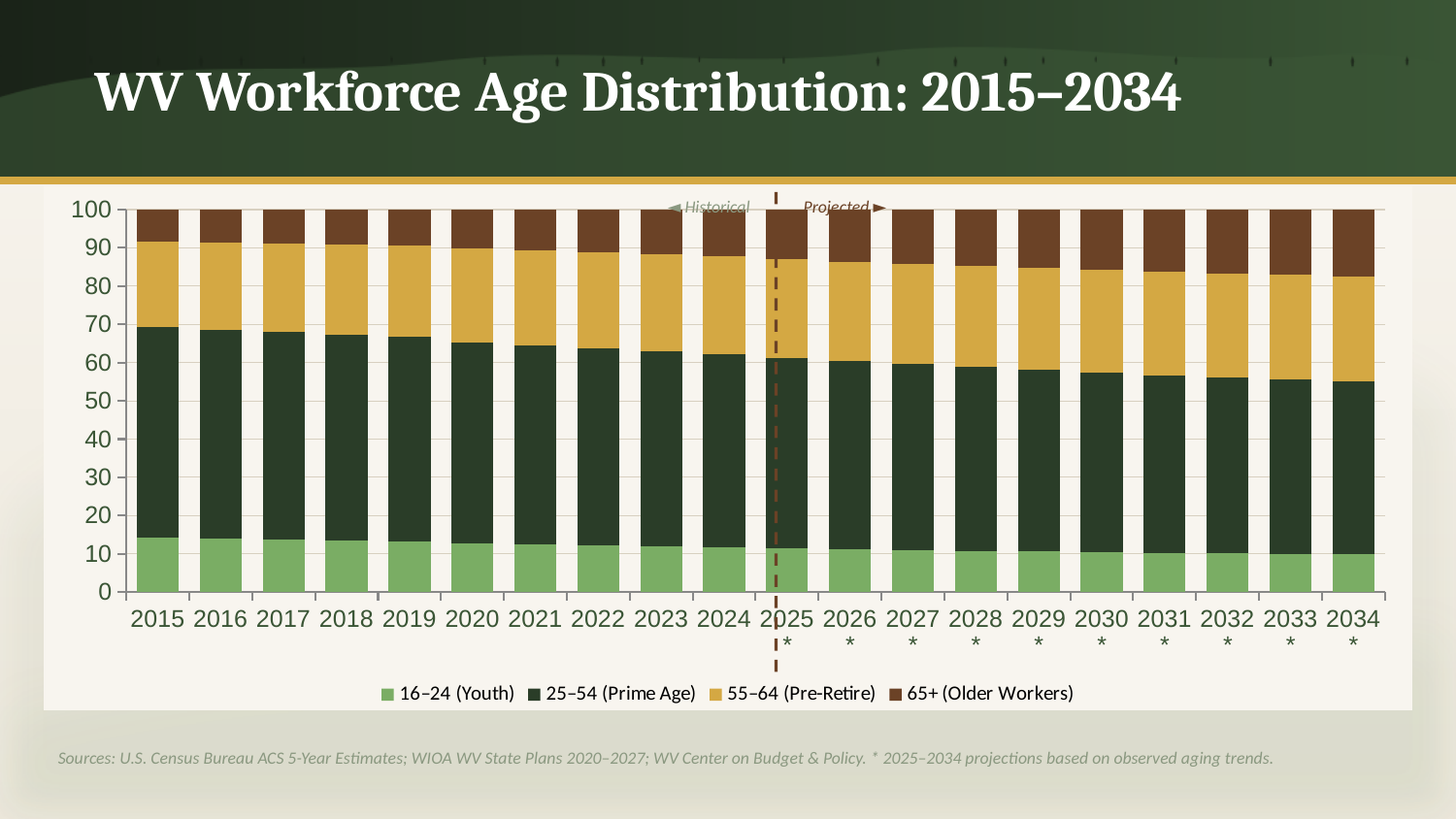
What kind of chart is shown on the slide? Stacked bar chart Is the value for the 16–24 (Youth) segment in 2015 greater or less than 10? greater How many series does the chart's legend list? 4 Is the 65+ (Older Workers) share larger in 2015 or in 2034? 2034 Does the share of the 65+ (Older Workers) group rise or fall from 2015 to 2034? Rise What is the title of the chart on the slide? WV Workforce Age Distribution: 2015–2034 Is the 16–24 (Youth) share larger in 2015 or in 2034? 2015 How many years are shown along the x axis of the chart? 20 Which legend entry represents the 65+ age group? 65+ (Older Workers) Is the value for the 25–54 (Prime Age) segment in 2015 greater or less than 50? greater Does the share of the 16–24 (Youth) group rise or fall from 2015 to 2034? Fall Does the share of the 25–54 (Prime Age) group rise or fall across the years shown? Fall